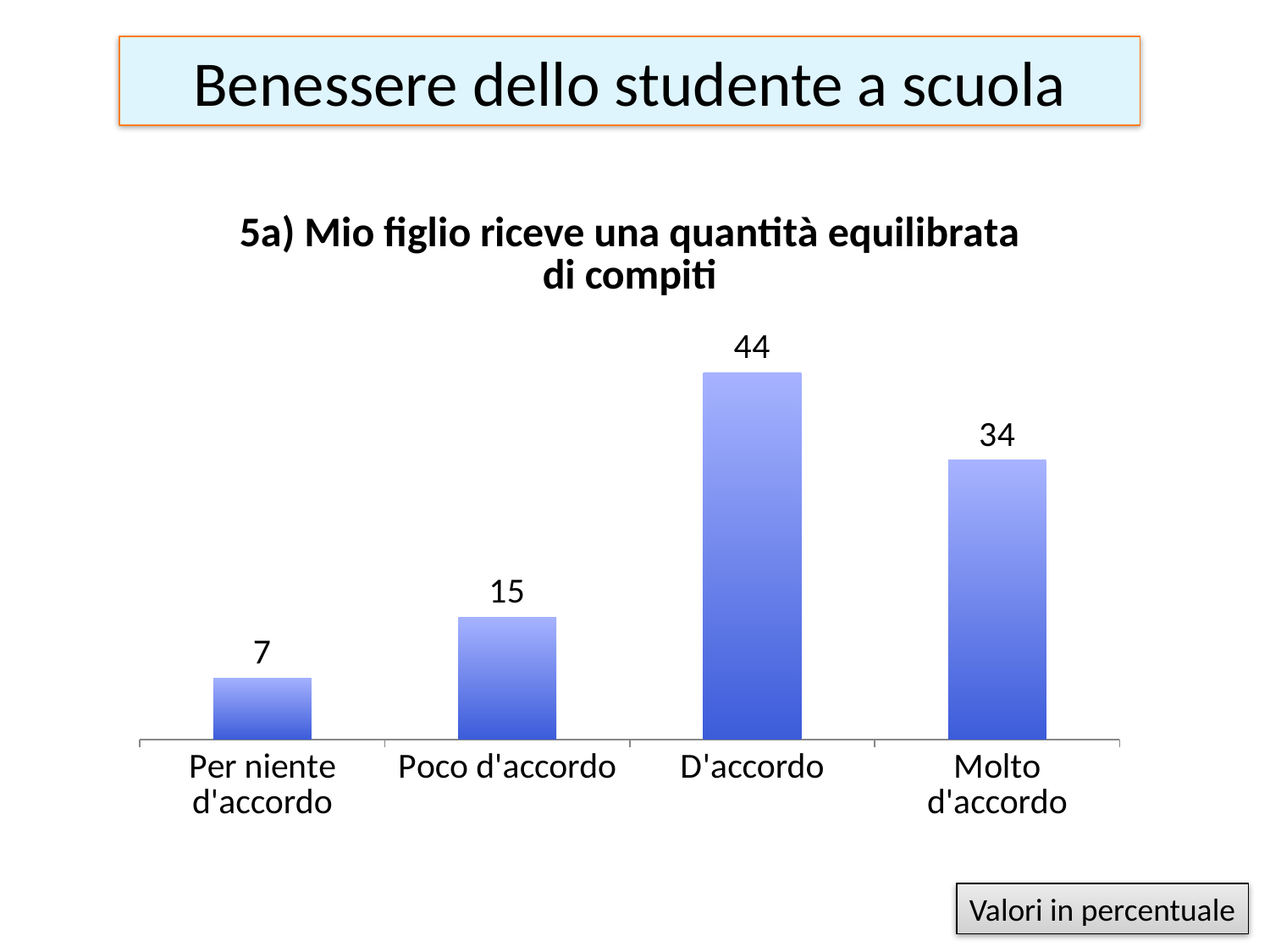
What is the difference between the values for "D'accordo" and "Molto d'accordo"? 10 What is the value for "D'accordo"? 44 What is the value for "Per niente d'accordo"? 7 What is the title of the chart? 5a) Mio figlio riceve una quantità equilibrata di compiti Which category has the lowest value? Per niente d'accordo According to the note on the slide, in what unit are the values expressed? Percentuale (percentage) What is the value for "Poco d'accordo"? 15 Which is larger, the value for "Poco d'accordo" or the value for "Molto d'accordo"? Molto d'accordo What is the value for "Molto d'accordo"? 34 Which category has the highest value? D'accordo How many categories are shown on the x axis? 4 What kind of chart is shown on the slide? Bar chart